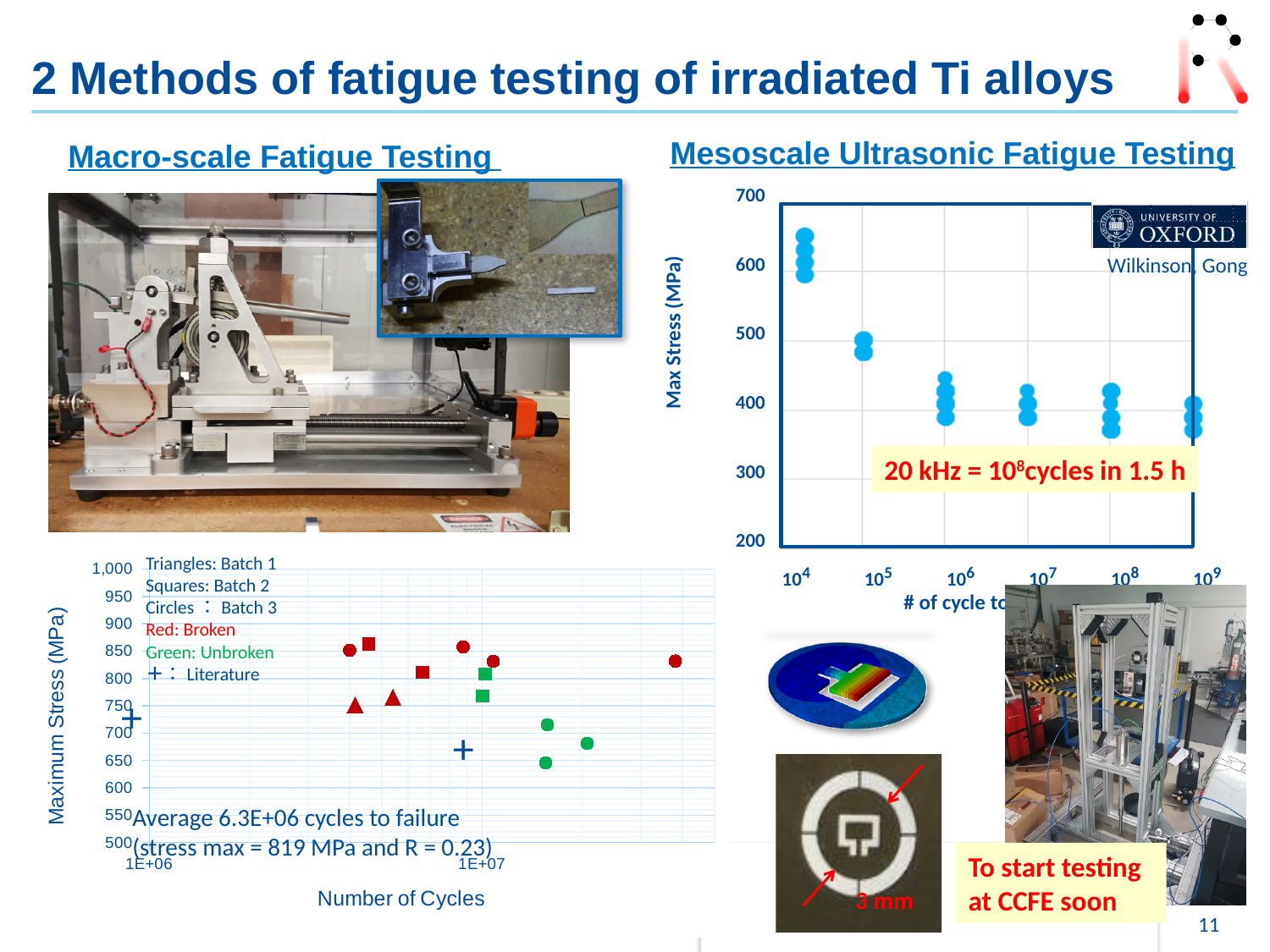
In the Mesoscale Ultrasonic Fatigue Testing chart, are the points at 10^9 cycles greater or less than 500 MPa? less In the Mesoscale Ultrasonic Fatigue Testing chart, are the points at 10^4 cycles greater or less than 500 MPa? greater In the Mesoscale Ultrasonic Fatigue Testing chart, how many labelled tick values are on the x axis? 6 In the Mesoscale Ultrasonic Fatigue Testing chart, does Max Stress rise or fall as the number of cycles increases? fall What kind of chart is the Macro-scale Fatigue Testing chart at the bottom left? scatter chart In the Macro-scale Fatigue Testing chart, how many green circle points are plotted? 3 What does the yellow annotation on the Mesoscale Ultrasonic Fatigue Testing chart say? 20 kHz = 10^8 cycles in 1.5 h What kind of chart is the Mesoscale Ultrasonic Fatigue Testing chart on the right? scatter chart In the Macro-scale Fatigue Testing chart, what is the stated average number of cycles to failure? 6.3E+06 In the Macro-scale Fatigue Testing chart, which colour represents broken specimens? Red In the Macro-scale Fatigue Testing chart, what stress max is stated in the annotation? 819 MPa In the Macro-scale Fatigue Testing chart, is the literature (+) point near 1E+07 cycles greater or less than 700 MPa? less